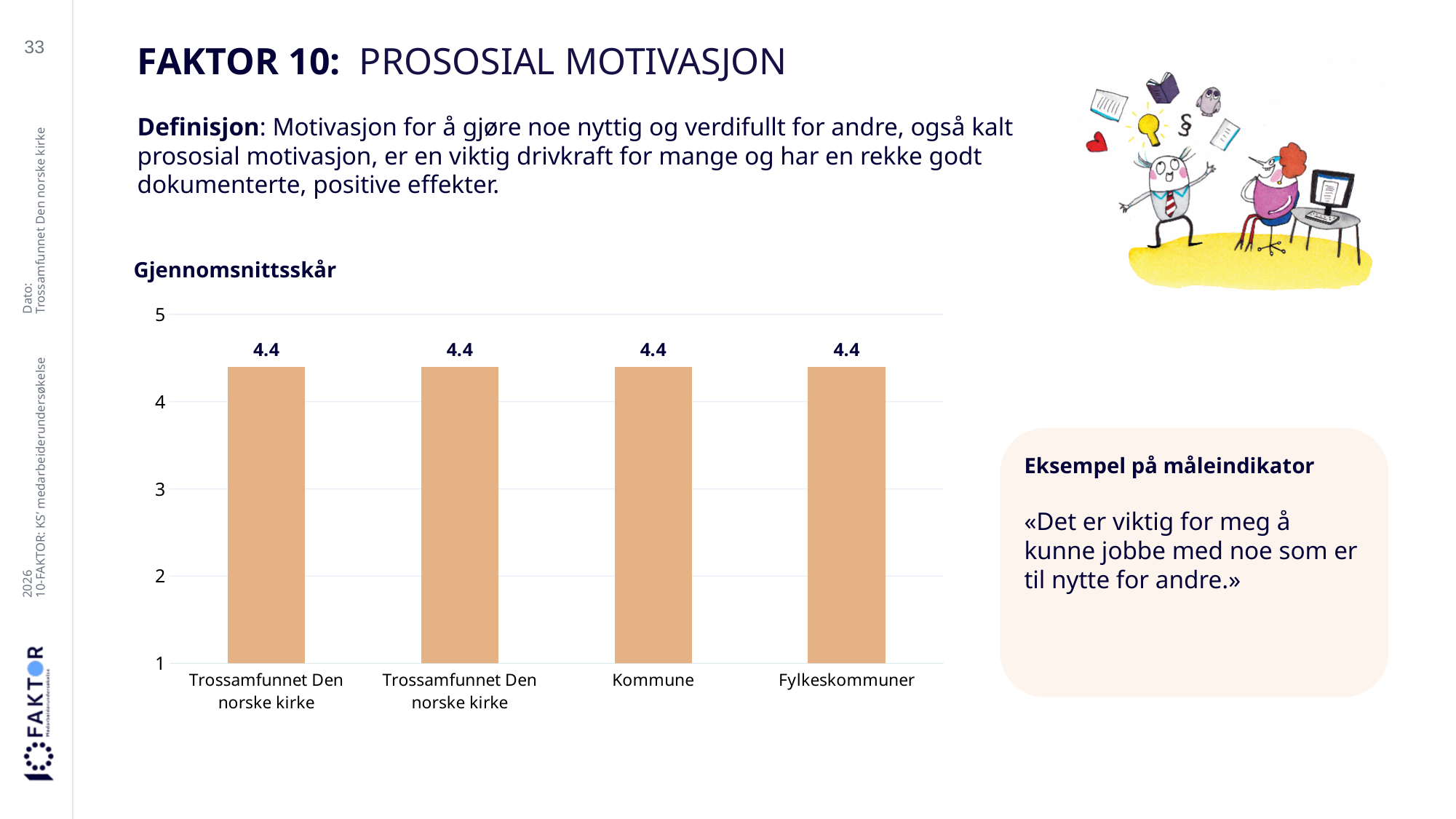
What is the value for Kommune? 4.4 What is the value shown for the first bar, Trossamfunnet Den norske kirke? 4.4 Which is larger, the value for Kommune or the value for Fylkeskommuner? They are equal What is the difference between the values for Kommune and Fylkeskommuner? 0 How many bars are plotted in the chart? 4 What is the highest value shown on the y axis? 5 Do the values rise, fall, or stay the same across the categories from left to right? Stay the same What kind of chart is shown on the slide? Bar chart Is the value for Fylkeskommuner greater or less than 5? less What is the title of the chart? Gjennomsnittsskår Is the value for Kommune greater or less than 4? greater What is the value for Fylkeskommuner? 4.4